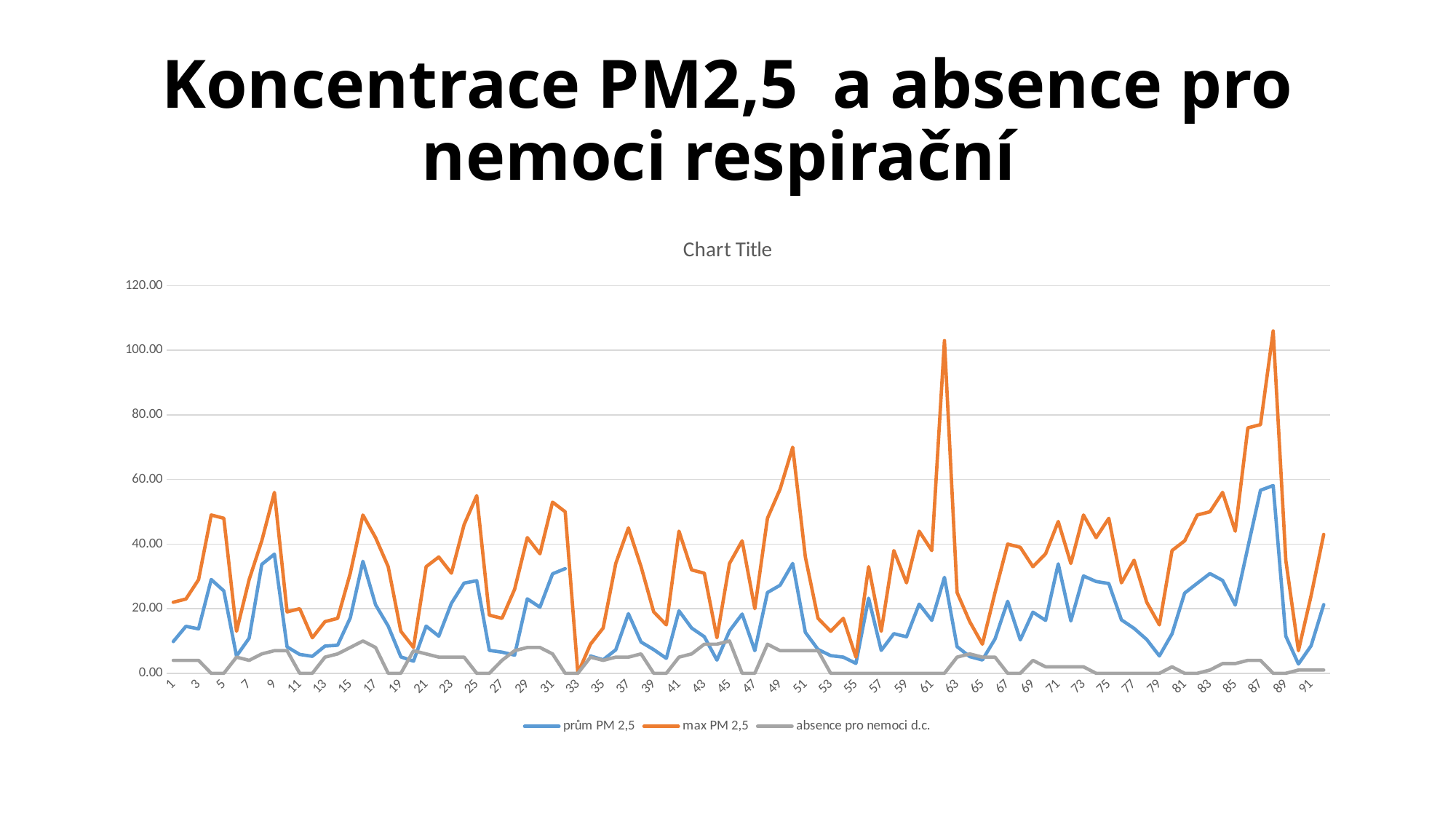
What are the names of the three series in the legend? prům PM 2,5; max PM 2,5; absence pro nemoci d.c. Is the value of 'prům PM 2,5' at point 9 greater or less than 40? less Is the value of 'max PM 2,5' at point 50 greater or less than 60? greater Is the value of 'max PM 2,5' at point 88 greater or less than 100? greater How many series does the chart legend list? 3 Which colour is used for the 'max PM 2,5' series? orange At point 88, which series has the higher value, 'max PM 2,5' or 'prům PM 2,5'? max PM 2,5 What kind of chart is shown on the slide? line chart Which series reaches the highest value anywhere on the chart? max PM 2,5